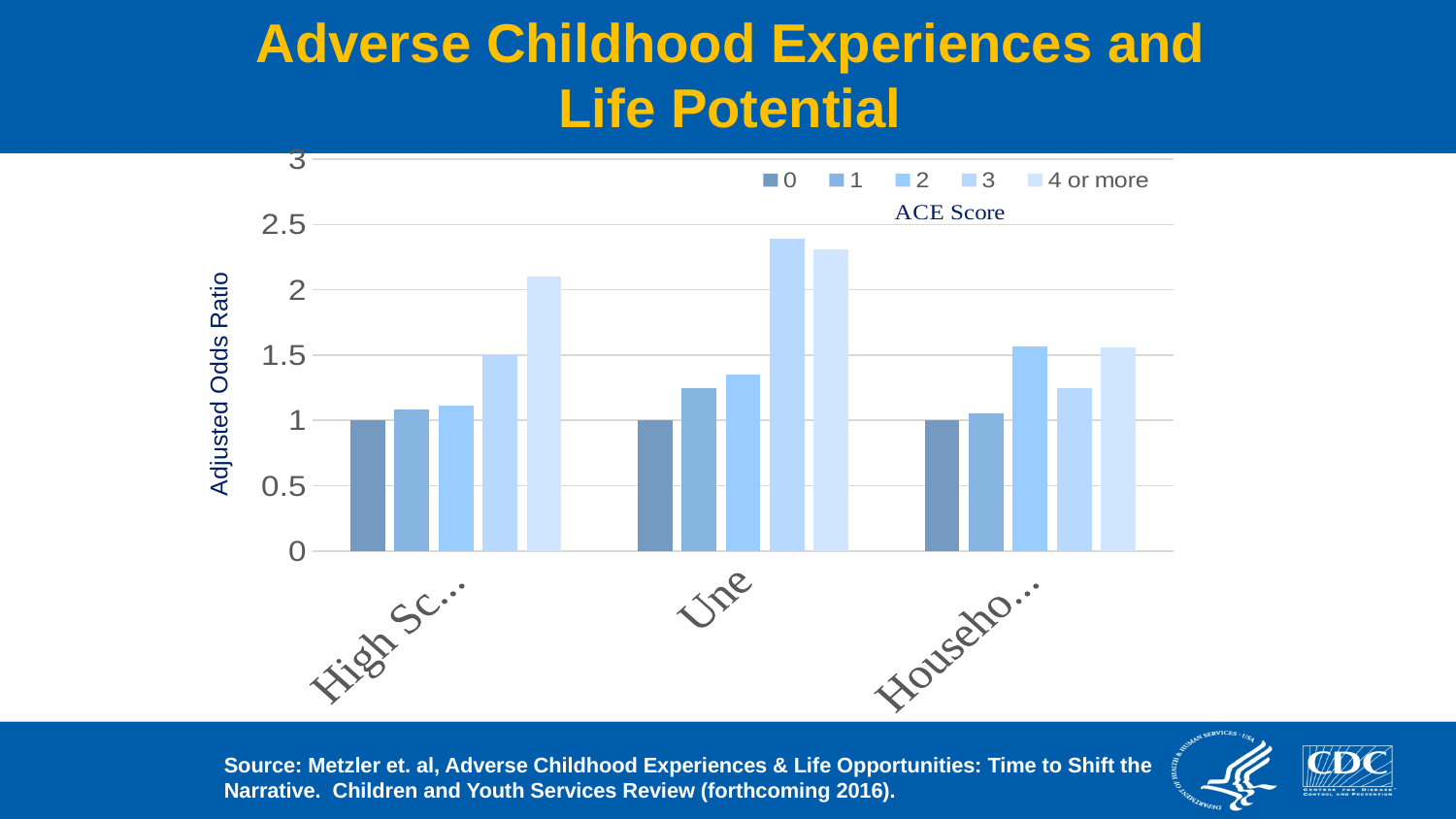
Is the value for an ACE score of 1 in the third group ("Househo...") greater or less than 1.5? less What title is shown above the legend entries? ACE Score What is the adjusted odds ratio for an ACE score of 0 in the first group ("High Sc...")? 1 What kind of chart is shown on the slide? bar chart How many series does the legend list? 5 What is the title of the y axis? Adjusted Odds Ratio Which is larger: the "4 or more" bar in the middle group ("Une") or the "4 or more" bar in the first group ("High Sc...")? the middle group ("Une") In the first group ("High Sc..."), which ACE score has the highest bar? 4 or more Is the value for an ACE score of 3 in the middle group ("Une") greater or less than 2? greater How many category groups are plotted along the x axis? 3 Is the value for "4 or more" in the first group ("High Sc...") greater or less than 1.5? greater What is the adjusted odds ratio for an ACE score of 0 in the middle group ("Une")? 1